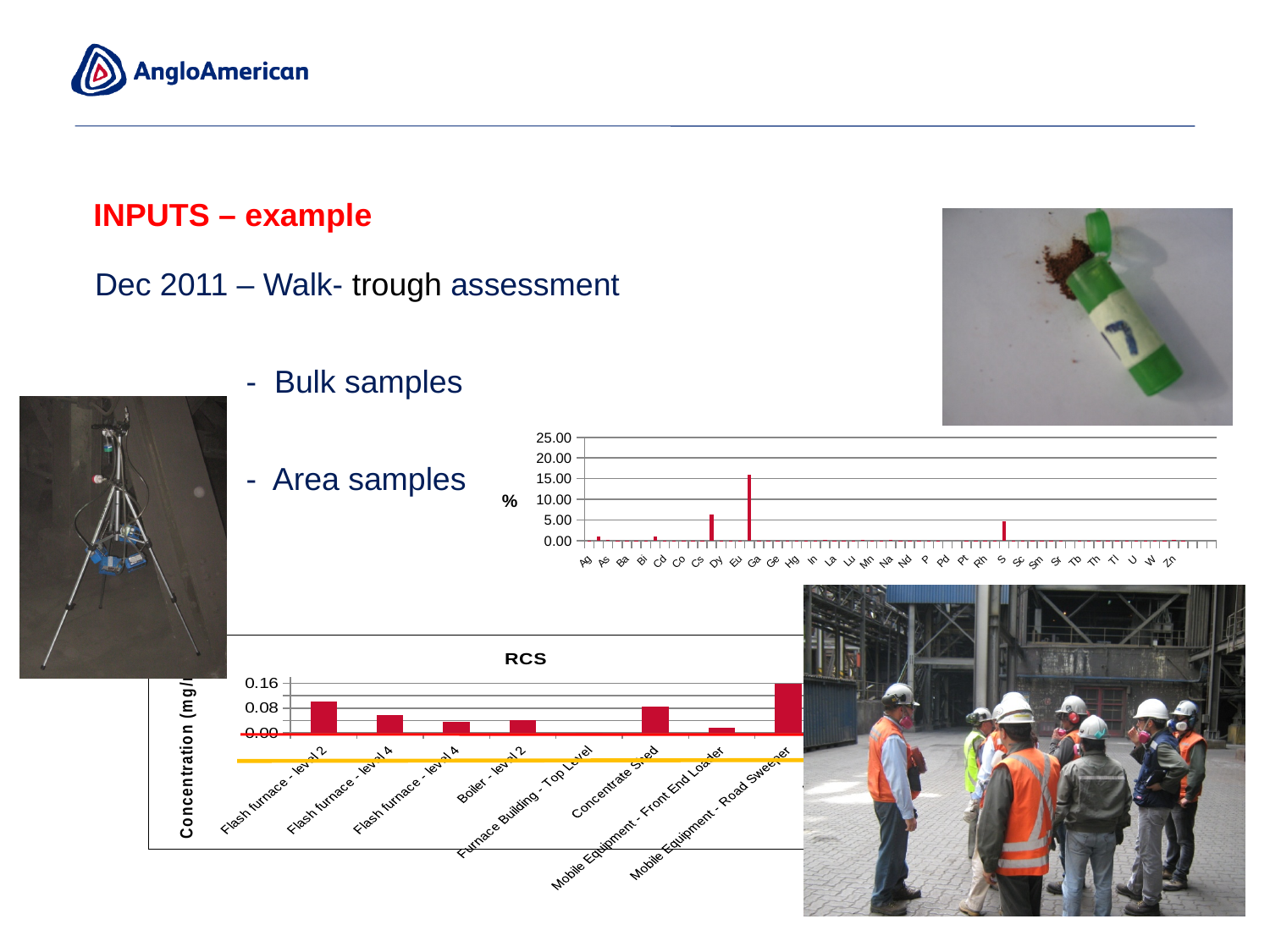
In the chart with the % axis, is the value for Dy greater or less than 10.00? less In the chart with the % axis, is the value for S greater or less than 10.00? less In the RCS chart, is the value for Mobile Equipment - Front End Loader greater or less than 0.08? less What kind of chart is the chart with the % axis at the top right of the slide? bar chart In the RCS chart, which is larger, the value for Flash furnace - level 2 or the value for Mobile Equipment - Front End Loader? Flash furnace - level 2 What kind of chart is the RCS chart at the bottom of the slide? bar chart In the RCS chart, which category has the highest bar? Mobile Equipment - Road Sweeper What is the title of the bar chart at the bottom of the slide? RCS